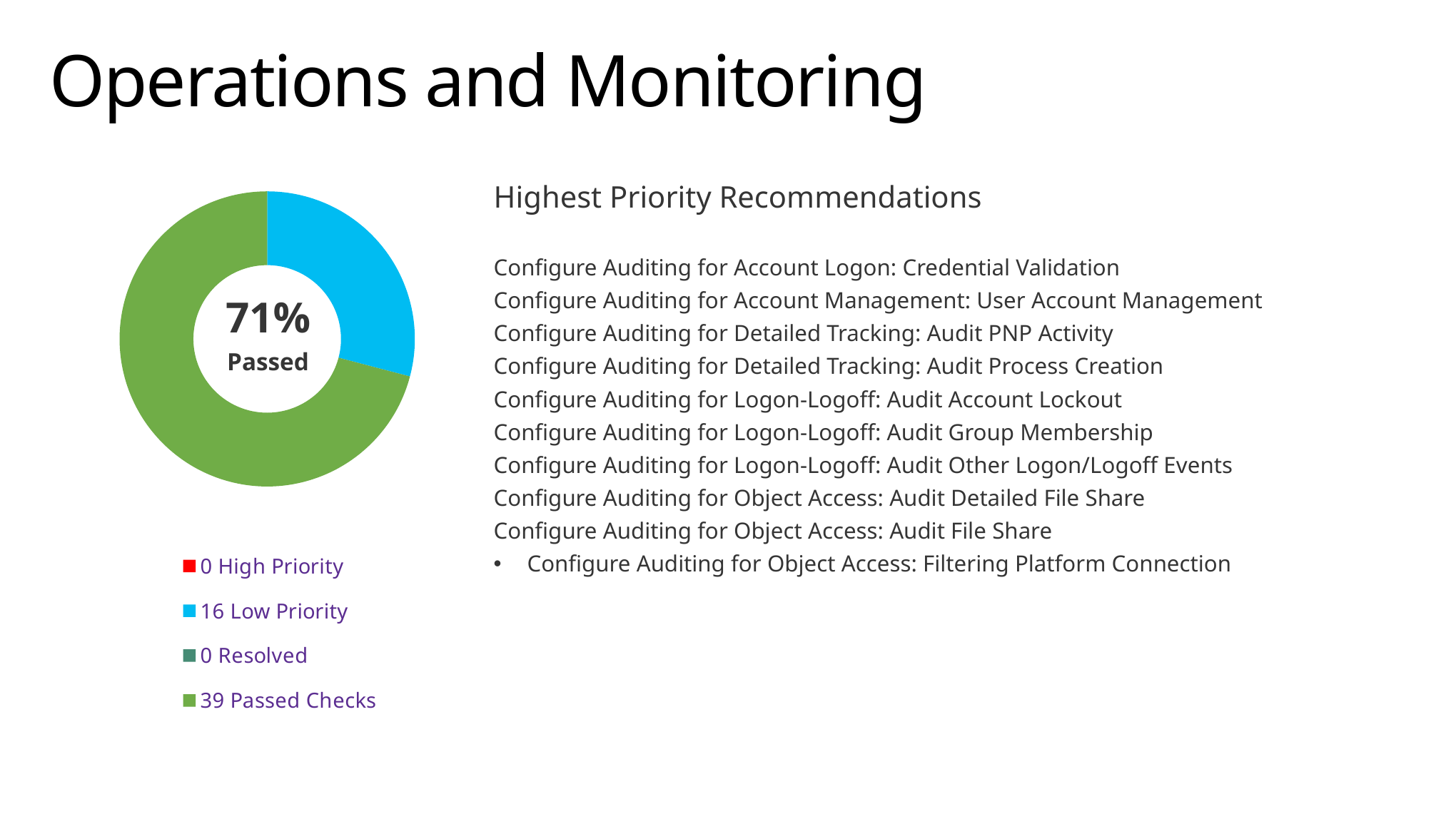
How many Low Priority items does the chart show? 16 How many High Priority items does the chart show? 0 What is the total of all categories in the chart? 55 How many Resolved items does the chart show? 0 What percentage is shown in the centre of the doughnut chart? 71% What colour represents Passed Checks in the chart? Green What kind of chart is shown on the slide? Doughnut chart How many Passed Checks does the chart show? 39 How many categories does the chart's legend list? 4 What is the difference between Passed Checks and Low Priority? 23 Which category has the highest value in the chart? Passed Checks Which is larger, Low Priority or Passed Checks? Passed Checks